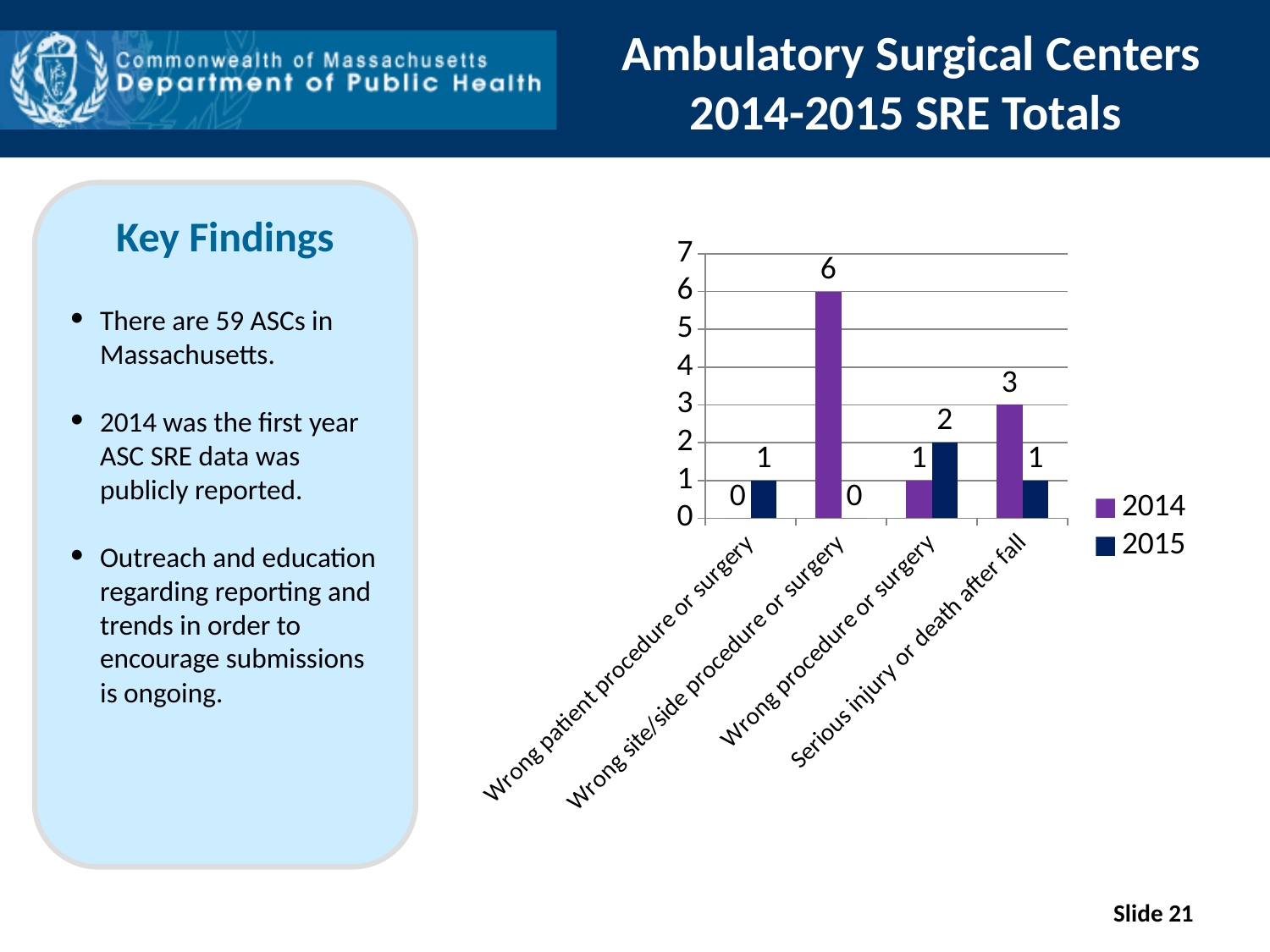
What is the 2015 value for Wrong patient procedure or surgery? 1 Which series is shown in purple in the legend? 2014 What type of chart is shown on the slide? Bar chart For Wrong procedure or surgery, which year has the larger value, 2014 or 2015? 2015 What is the 2014 value for Wrong site/side procedure or surgery? 6 Which category has the lowest 2015 value? Wrong site/side procedure or surgery What is the 2014 value for Serious injury or death after fall? 3 How many series does the legend list? 2 Which category has the highest 2014 value? Wrong site/side procedure or surgery What is the difference between the 2014 and 2015 values for Serious injury or death after fall? 2 How many categories are shown on the x axis of the chart? 4 What is the 2015 value for Wrong procedure or surgery? 2